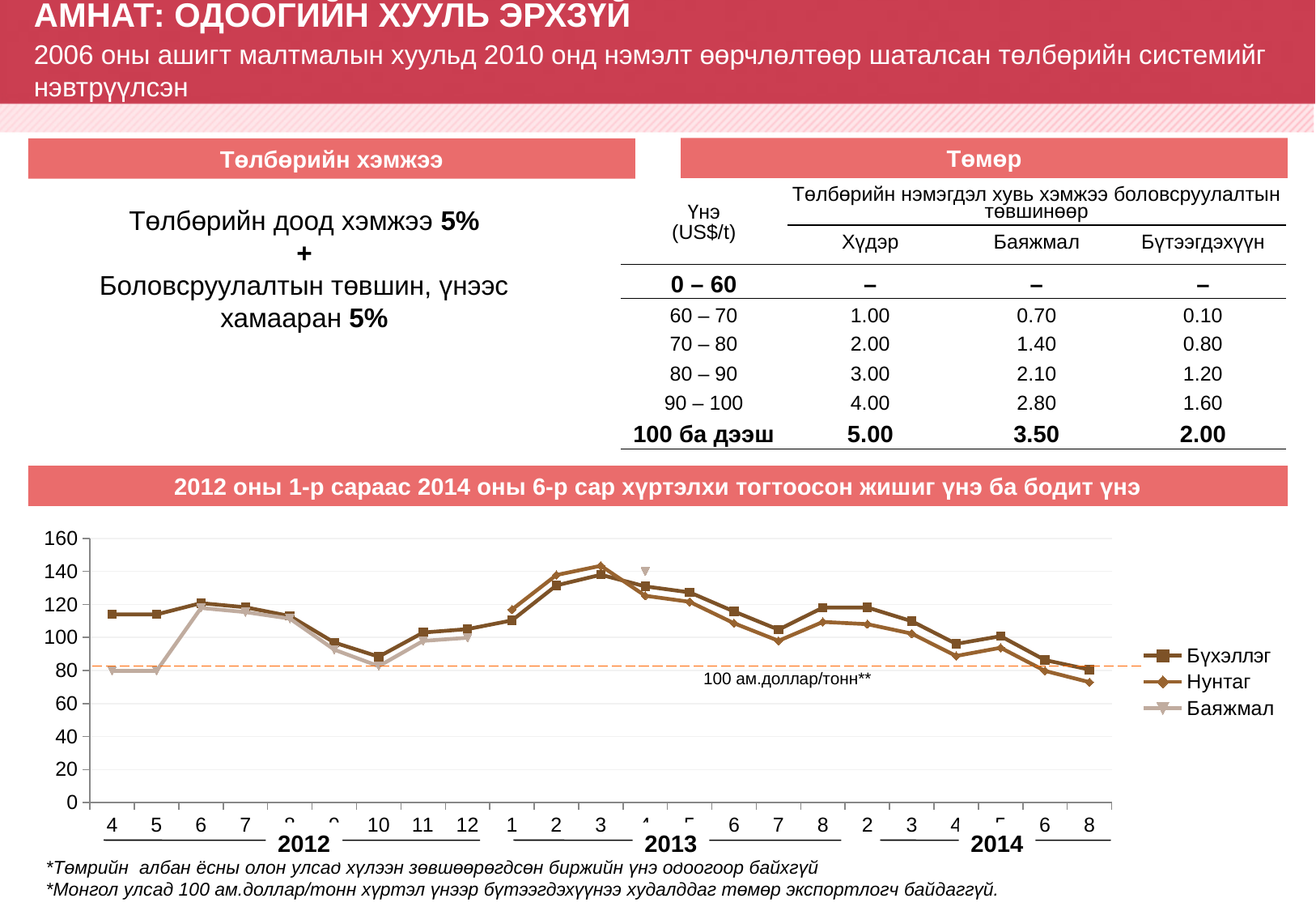
In the line chart, in which month and year does the Бүхэллэг series reach its lowest value? month 8 of 2014 In the line chart, does the Бүхэллэг series generally rise or fall from month 3 of 2013 to month 8 of 2014? fall In the line chart, which series is higher in month 8 of 2014, Бүхэллэг or Нунтаг? Бүхэллэг In the line chart, in which month and year does the Бүхэллэг series reach its highest value? month 3 of 2013 What kind of chart is shown at the bottom of the slide? line chart What is the title of the line chart? 2012 оны 1-р сараас 2014 оны 6-р сар хүртэлхи тогтоосон жишиг үнэ ба бодит үнэ In the line chart, is the value for Бүхэллэг in month 8 of 2013 greater or less than 100? greater In the line chart, is the value for Бүхэллэг in month 4 of 2012 greater or less than 100? greater In the line chart, is the value for Нунтаг in month 8 of 2014 greater or less than 80? less What are the three series named in the legend of the line chart? Бүхэллэг, Нунтаг, Баяжмал How many series does the legend of the line chart list? 3